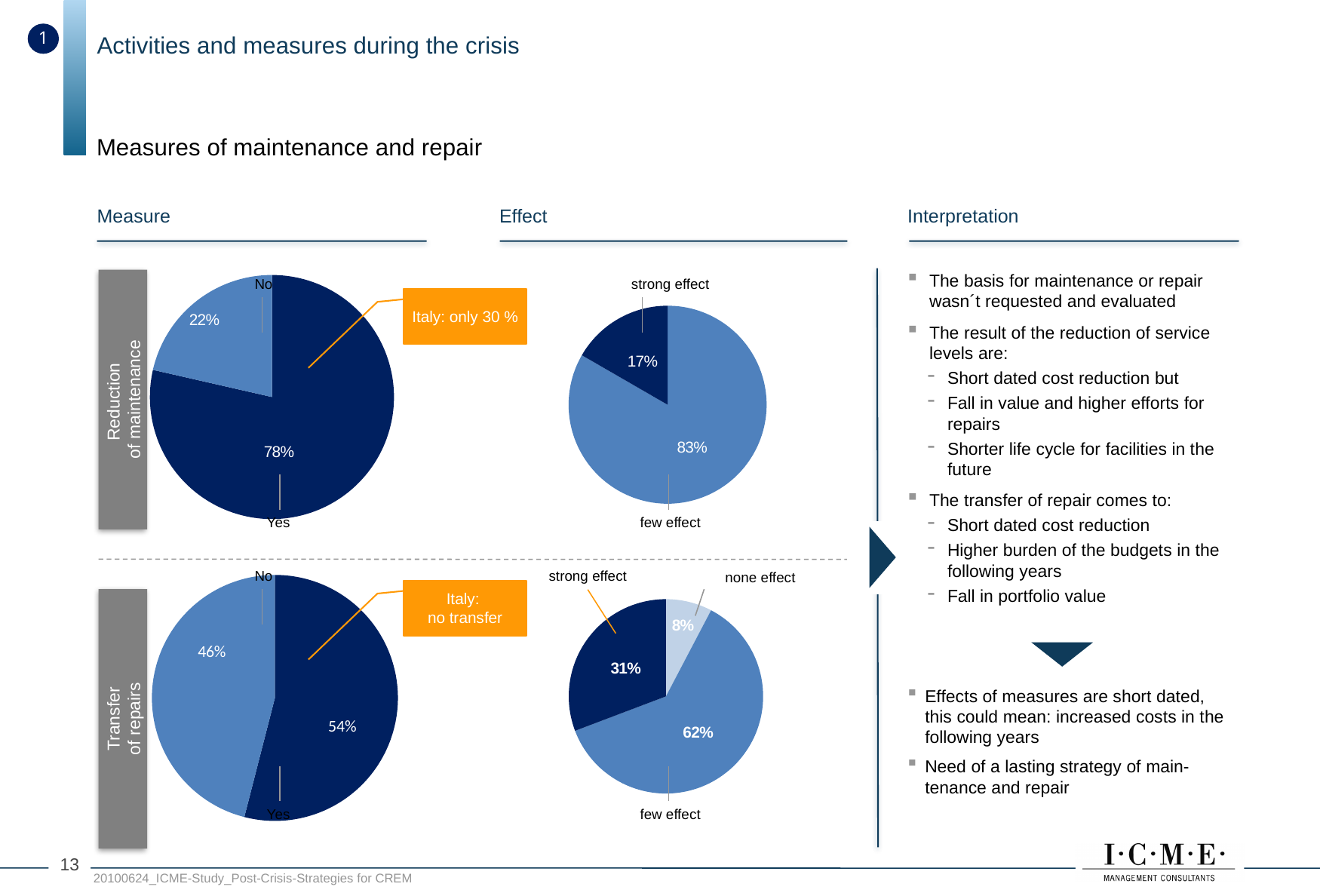
In the Effect pie chart for Reduction of maintenance (top right), what share reported few effect? 83% In the Measure pie chart for Reduction of maintenance (top left), which is larger, Yes or No? Yes In the Effect pie chart for Reduction of maintenance (top right), what share reported a strong effect? 17% In the Effect pie chart for Transfer of repairs (bottom right), what share reported none effect? 8% In the Measure pie chart for Transfer of repairs (bottom left), what is the difference between the Yes and No shares? 8% How many slices does the Effect pie chart for Transfer of repairs (bottom right) have? 3 In the Effect pie chart for Transfer of repairs (bottom right), which category has the largest slice? few effect What type of chart is used to show the Measure results for Reduction of maintenance (top left)? Pie chart In the Effect pie chart for Transfer of repairs (bottom right), which category has the smallest slice? none effect In the Measure pie chart for Reduction of maintenance (top left), what share answered No? 22% In the Measure pie chart for Transfer of repairs (bottom left), what share answered No? 46% In the Measure pie chart for Reduction of maintenance (top left), what share answered Yes? 78%